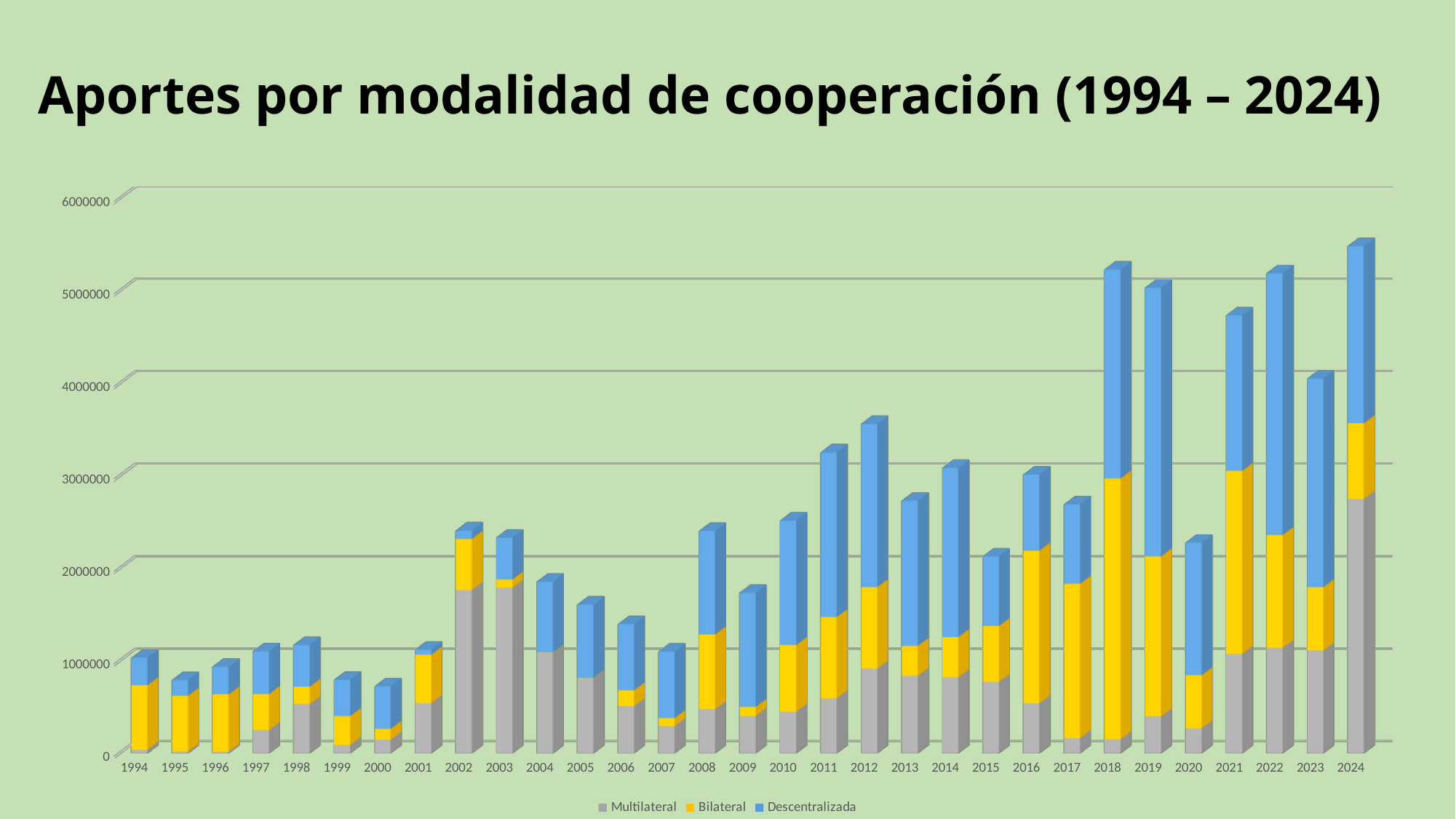
Is the total value for 2024 greater or less than 5000000? greater Which series is shown in yellow in the legend? Bilateral How many years (categories) are plotted along the x axis? 31 Which year has the tallest stacked bar overall? 2024 What kind of chart is shown on the slide? Stacked bar chart How many series does the legend list? 3 Which year has the taller stacked bar, 2002 or 2004? 2002 Is the total value for 2017 greater or less than 3000000? less What is the title of the chart? Aportes por modalidad de cooperación (1994 – 2024) Is the total value for 2005 greater or less than 2000000? less Do the total contributions generally rise or fall from 1994 to 2024? rise